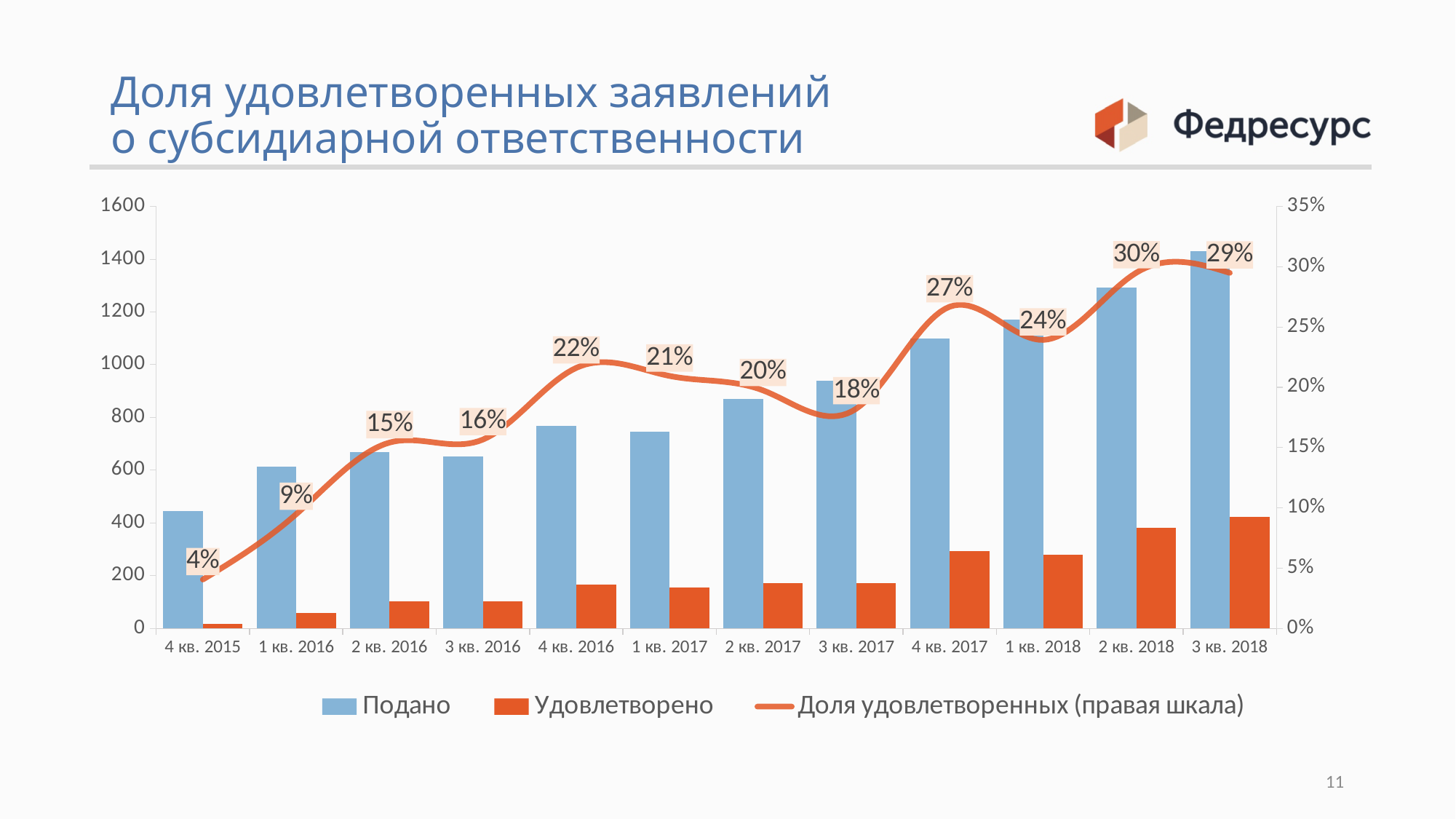
How many quarters are shown on the x axis? 12 In which quarter is the share of satisfied applications the highest? 2 кв. 2018 How many series does the legend list? 3 What is the share of satisfied applications (Доля удовлетворенных) in 4 кв. 2015? 4% Is the value of Подано for 3 кв. 2018 greater or less than 1400? greater Which quarter has a higher share of satisfied applications, 4 кв. 2016 or 3 кв. 2017? 4 кв. 2016 Is the value of Удовлетворено for 4 кв. 2015 greater or less than 200? less What kind of chart is shown on the slide? A combined bar chart and line chart What is the share of satisfied applications in 3 кв. 2018? 29% What is the share of satisfied applications in 4 кв. 2017? 27% In which quarter is the share of satisfied applications the lowest? 4 кв. 2015 By how many percentage points does the share of satisfied applications in 2 кв. 2018 exceed that in 4 кв. 2015? 26 percentage points